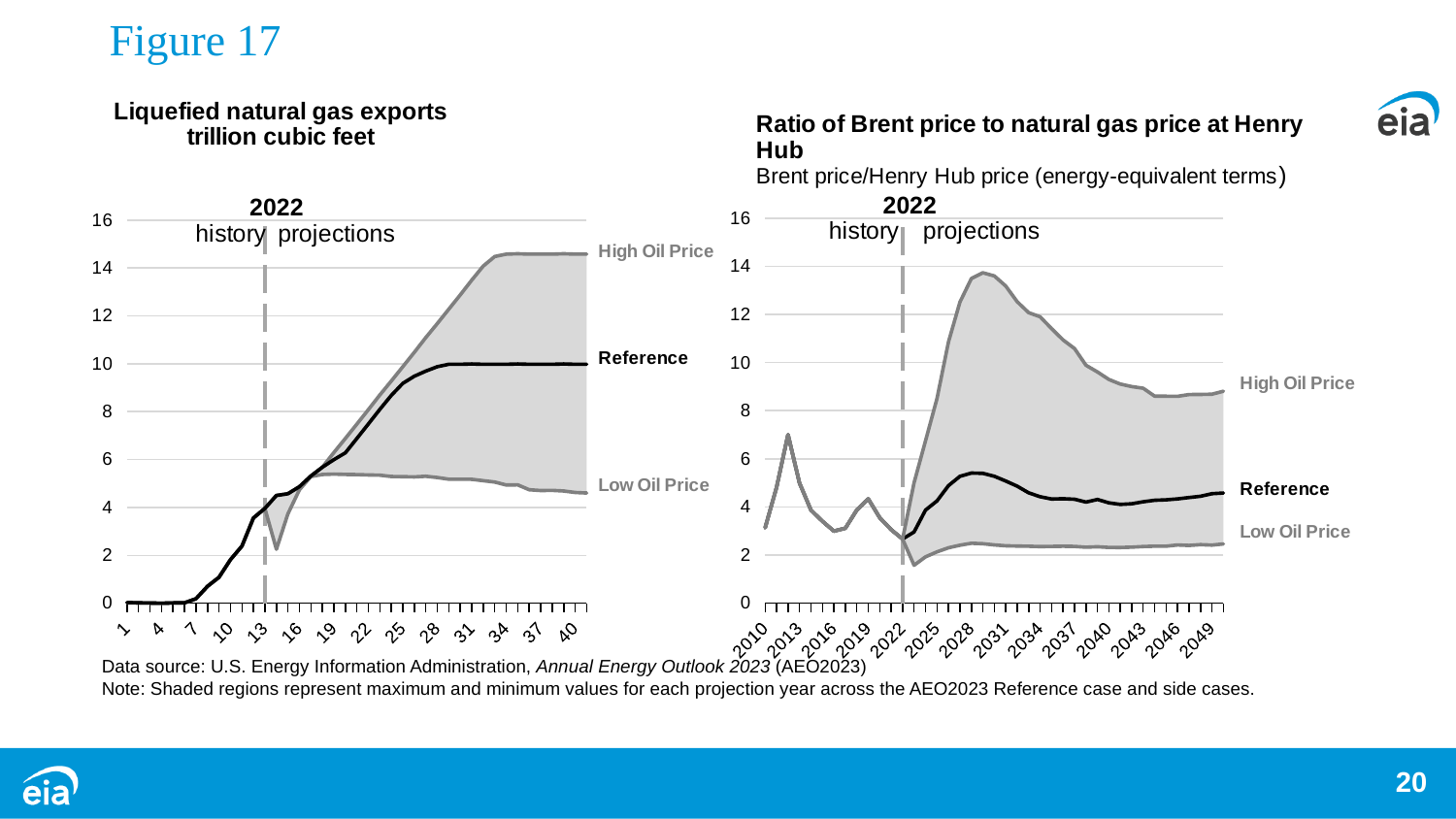
On the 'Ratio of Brent price to natural gas price at Henry Hub' chart, is the peak value of High Oil Price greater or less than 12? greater On the 'Liquefied natural gas exports' chart, is the final projected value for Reference greater or less than 8? greater On the 'Liquefied natural gas exports' chart, which series is lowest at the end of the projection period? Low Oil Price What kind of chart is the 'Liquefied natural gas exports' chart on the left? area and line chart (lines with a shaded band between them) On the 'Liquefied natural gas exports' chart, is the final projected value for Low Oil Price greater or less than 6? less How many named series (lines) are labeled on the 'Liquefied natural gas exports' chart? 3 On the 'Liquefied natural gas exports' chart, does the Reference line rise or fall from 2022 to the end of the projection period? rise On the 'Liquefied natural gas exports' chart, which series is highest at the end of the projection period? High Oil Price On the 'Ratio of Brent price to natural gas price at Henry Hub' chart, does the High Oil Price line rise or fall between 2031 and 2043? fall What year does the dashed vertical line separating history from projections mark on both charts? 2022